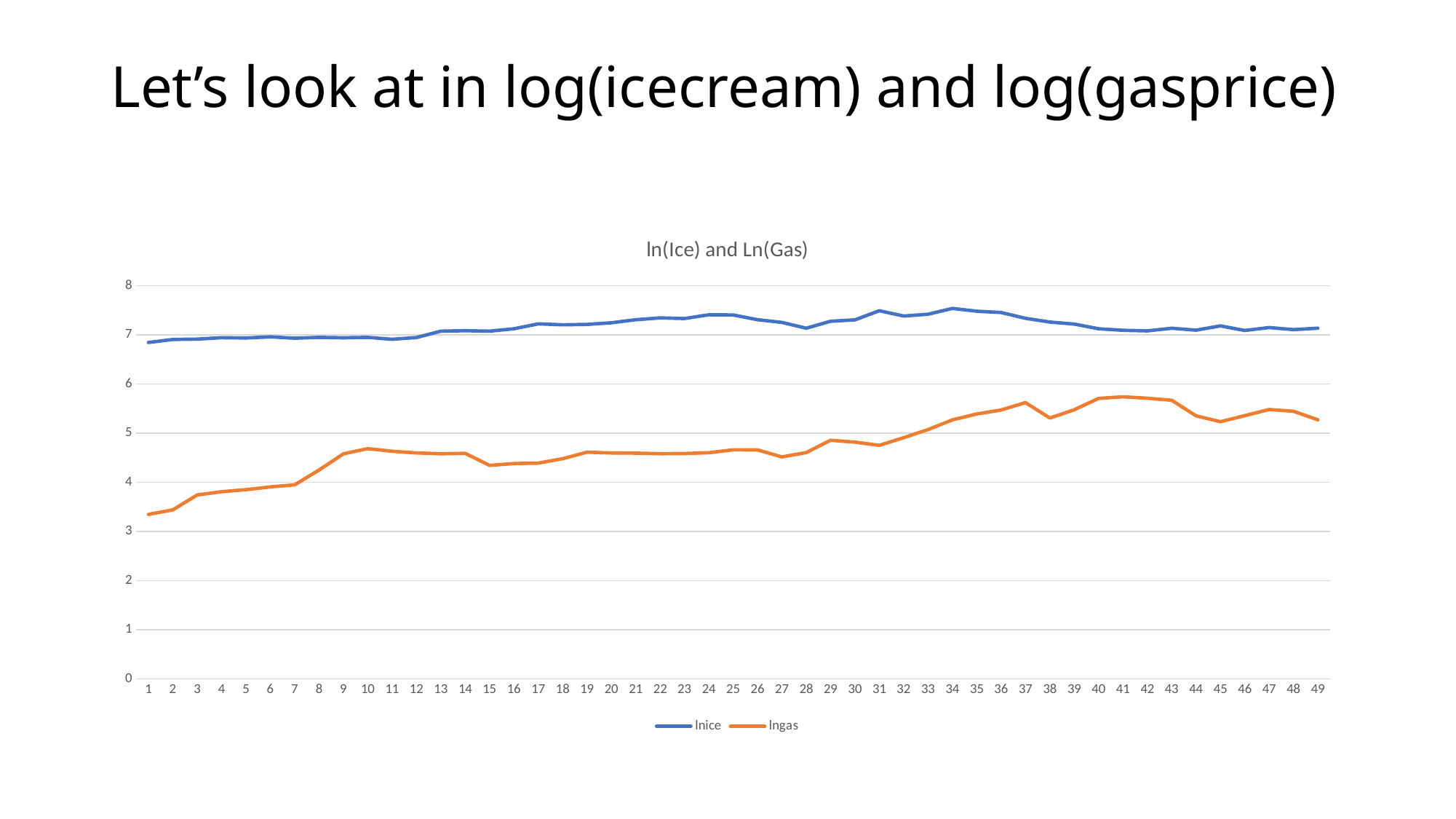
Which is larger for lngas, the value at point 1 or the value at point 49? point 49 Is the value of lngas at point 41 greater or less than 5? greater Is the value of lngas at point 1 greater or less than 4? less How many points are plotted along the x axis for each series? 49 What is the title of the chart? ln(Ice) and Ln(Gas) How many series does the legend list? 2 Is the value of lnice at point 34 greater or less than 7? greater Overall, does the lngas series rise or fall from point 1 to point 49? rise What kind of chart is shown on the slide? line chart Which colour is used for the lngas series? orange Which series has the higher value at point 25, lnice or lngas? lnice